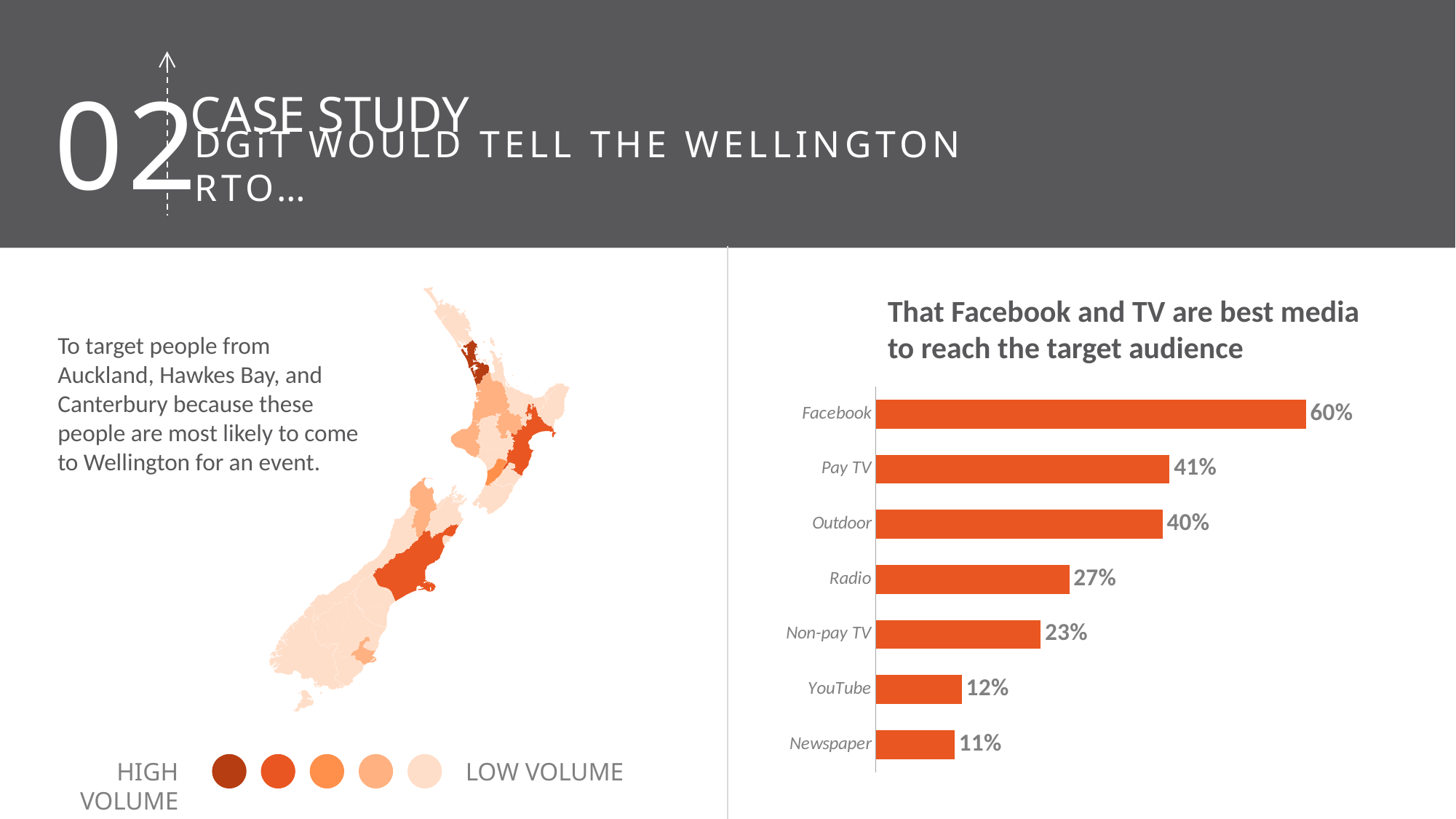
What is the title of the bar chart? That Facebook and TV are best media to reach the target audience What is the value for Facebook? 60% Which is larger, the value for Radio or the value for Non-pay TV? Radio What is the value for Radio? 27% What is the value for Outdoor? 40% Which media category has the highest value? Facebook What is the difference between the values for Non-pay TV and YouTube? 11% Which media category has the lowest value? Newspaper What is the value for Newspaper? 11% What kind of chart is used to show the media values? Bar chart How many media categories are shown in the bar chart? 7 What is the difference between the values for Facebook and Pay TV? 19%